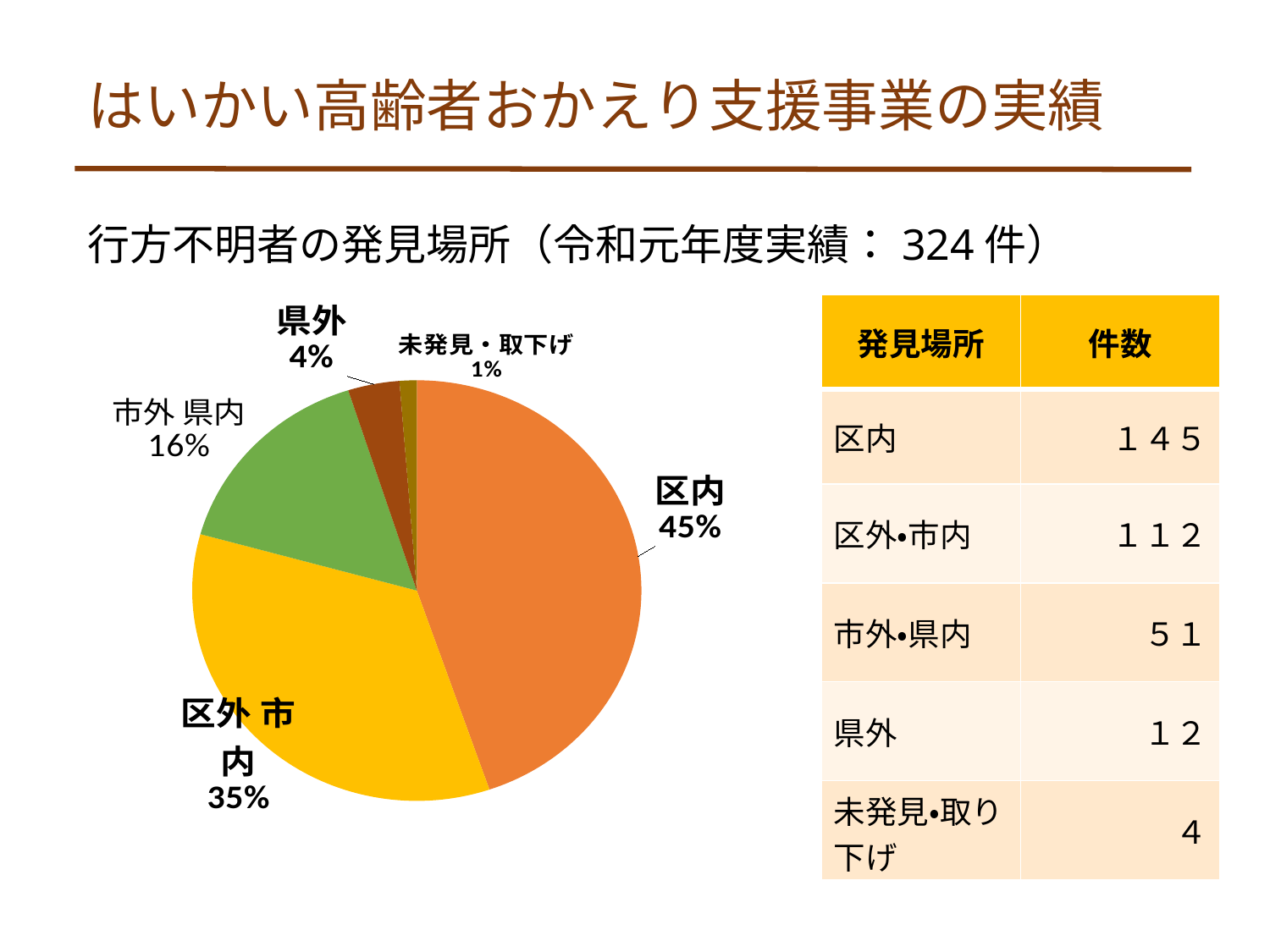
What share of the pie does 区外 市内 represent? 35% What share of the pie does 未発見・取下げ represent? 1% What kind of chart is shown on the slide? pie chart Which is larger in the pie chart, 市外 県内 or 県外? 市外 県内 What share of the pie does 県外 represent? 4% Which slice of the pie chart is the smallest? 未発見・取下げ Which slice of the pie chart is the largest? 区内 What colour is the 区内 slice of the pie chart? orange How many slices does the pie chart have? 5 What is the difference in percentage points between 区内 and 区外 市内? 10%